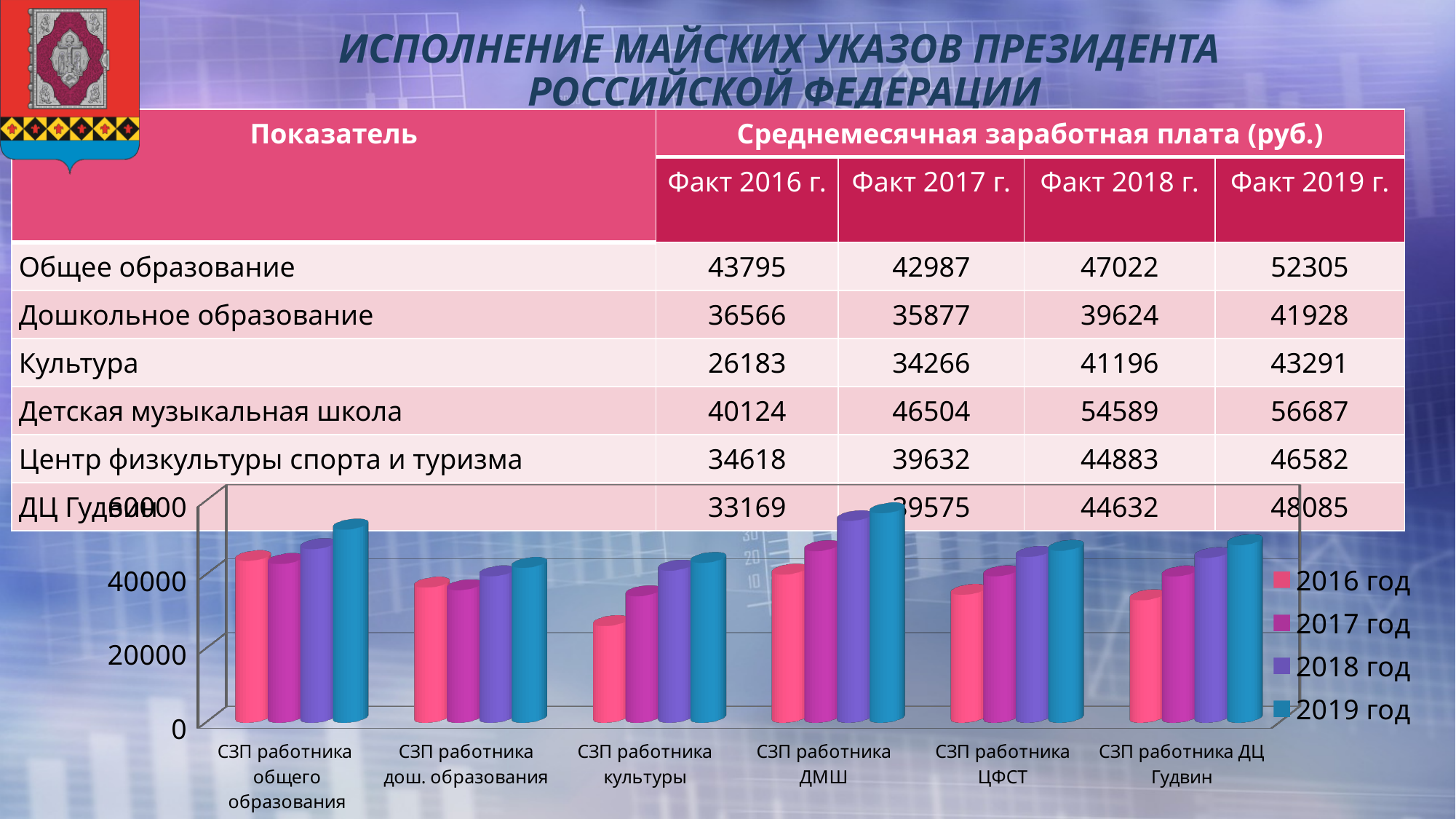
Is the 2016 год value for СЗП работника культуры greater or less than 20000? greater Which series in the chart legend is shown in blue? 2019 год Which category has the highest bar for the 2019 год series? СЗП работника ДМШ How many categories are shown along the x axis of the chart? 6 Which is larger in the chart: the 2019 год value for СЗП работника ДМШ or the 2019 год value for СЗП работника ЦФСТ? СЗП работника ДМШ Is the 2016 год value for СЗП работника культуры greater or less than 40000? less Is the 2019 год value for СЗП работника ДМШ greater or less than 40000? greater Which category has the lowest bar for the 2016 год series? СЗП работника культуры What kind of chart is shown at the bottom of the slide? bar chart How many series does the chart legend list? 4 Do the bars for СЗП работника культуры rise or fall from 2016 год to 2019 год? rise